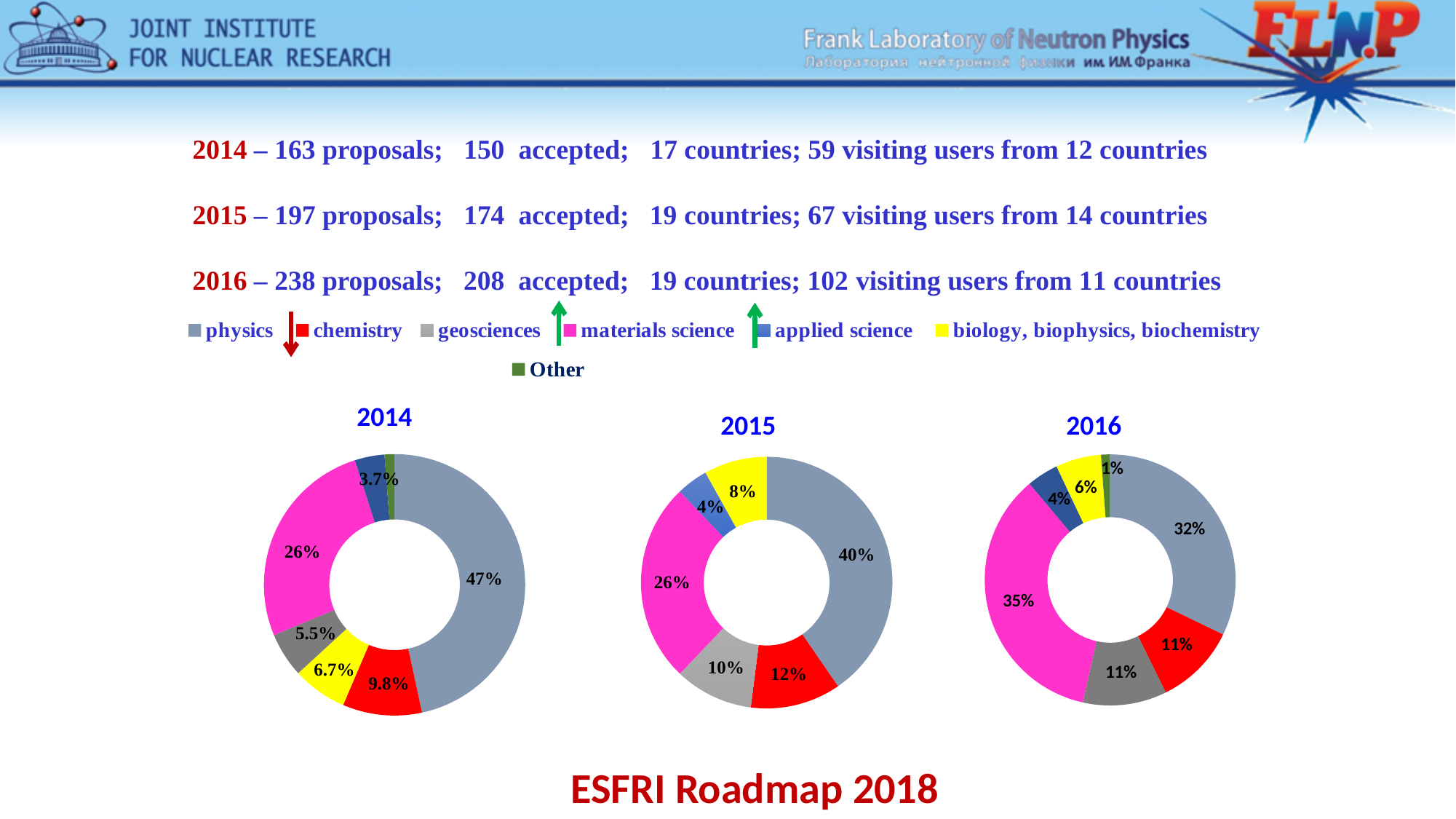
In the 2016 chart, which category has the largest share? materials science In the 2014 chart, what is the difference between the physics share and the materials science share? 21% In the 2015 chart, what is the value for geosciences? 10% What kind of chart is used for the 2014, 2015 and 2016 data? doughnut chart In the 2014 chart, what share of the doughnut is physics? 47% Across the 2014, 2015 and 2016 charts, does the physics share rise or fall over the years? fall In the 2015 chart, which category has the smallest share? applied science How many categories does the legend list for the charts? 7 In the 2014 chart, what is the value for chemistry? 9.8% In the 2016 chart, what is the value for the Other category? 1% In the 2016 chart, what is the value for materials science? 35% In the 2015 chart, which is larger, the chemistry share or the biology, biophysics, biochemistry share? chemistry